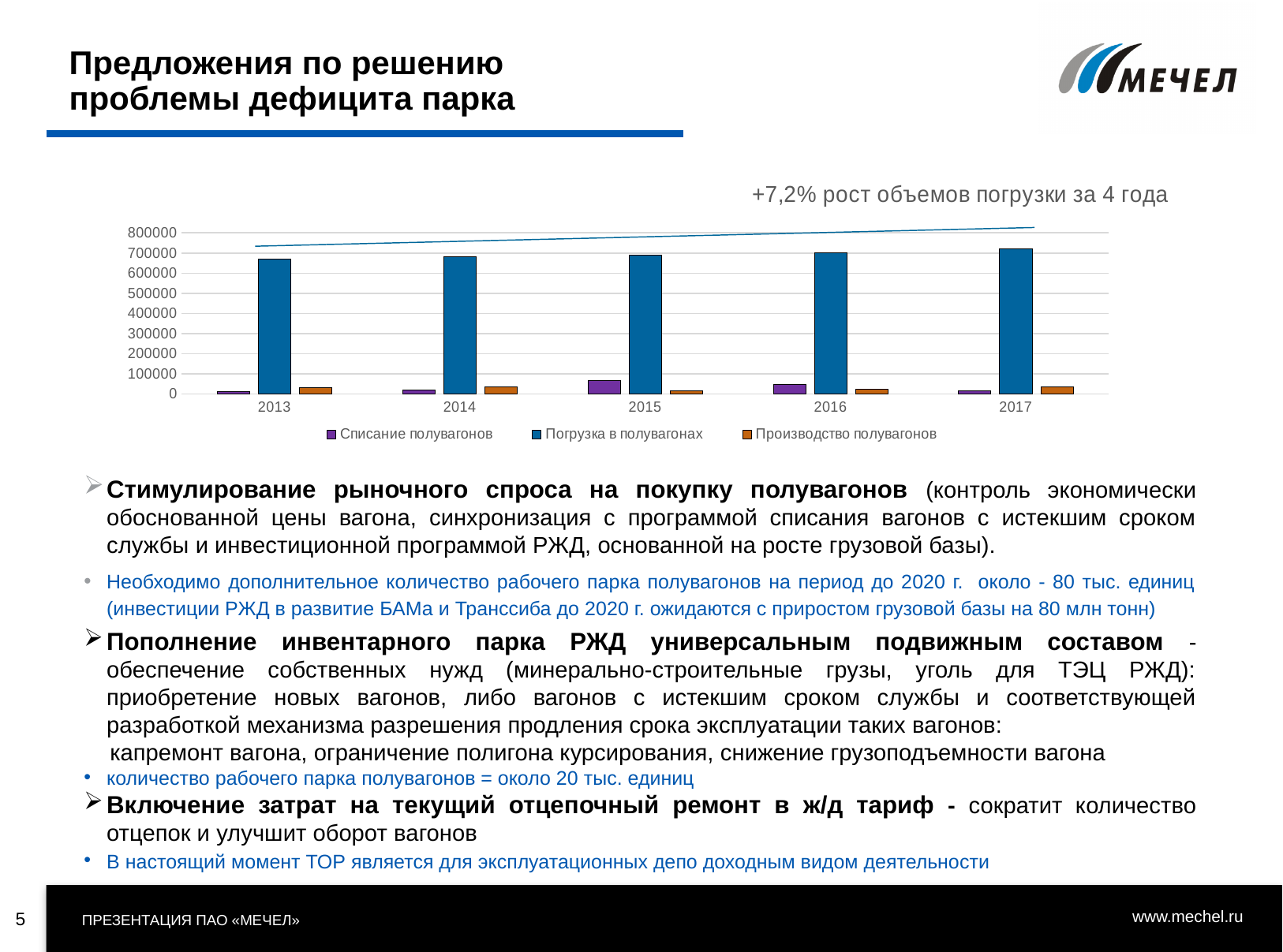
Is the value for Погрузка в полувагонах in 2017 greater or less than 700000? greater In 2015, which is larger: Списание полувагонов or Производство полувагонов? Списание полувагонов Which year has the highest value for Списание полувагонов? 2015 What growth in loading volumes over 4 years is stated above the chart? +7,2% Do the values for Погрузка в полувагонах rise or fall from 2013 to 2017? rise How many series does the chart legend list? 3 How many years are shown on the x axis of the chart? 5 Which year has the highest value for Погрузка в полувагонах? 2017 Which year has the lowest value for Производство полувагонов? 2015 What kind of chart is shown on the slide? bar chart Is the value for Погрузка в полувагонах in 2013 greater or less than 600000? greater Is the value for Списание полувагонов in 2015 greater or less than 100000? less